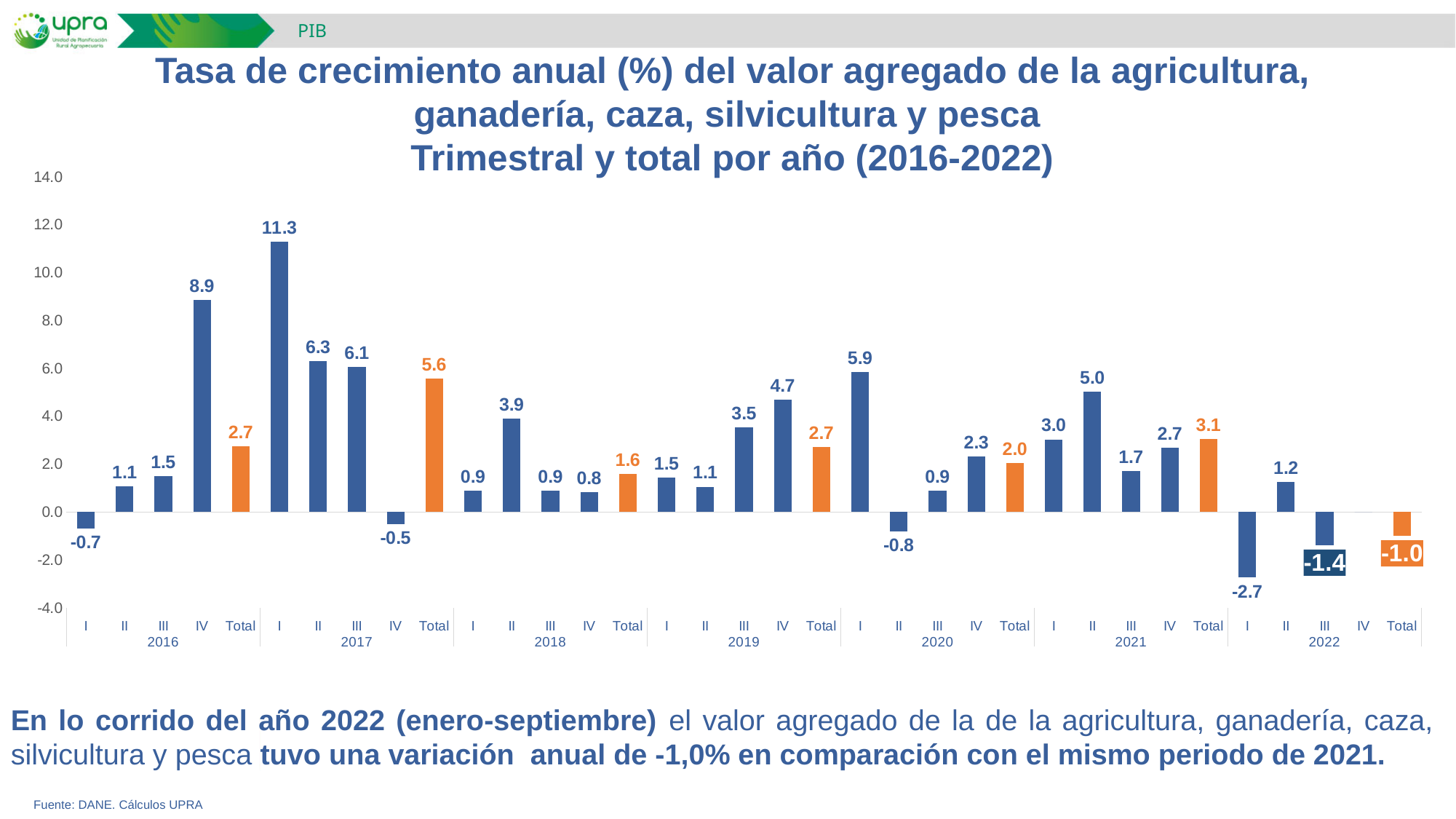
Which is larger: the value for quarter IV of 2016 or quarter I of 2020? IV 2016 What is the total annual growth rate shown for 2021? 3.1 How many annual 'Total' bars are shown in the chart? 7 What kind of chart is shown on the slide? bar chart What is the difference between quarter II and quarter III of 2021? 3.3 What is the total annual growth rate shown for 2022? -1.0 Is the value for quarter IV of 2016 greater or less than 8.0? greater What is the annual growth rate for quarter I of 2017? 11.3 Which quarter has the highest growth rate in the chart? I 2017 Which quarter has the lowest growth rate in the chart? I 2022 What is the difference between the 2017 total and the 2016 total? 2.9 What colour are the annual 'Total' bars in the chart? orange